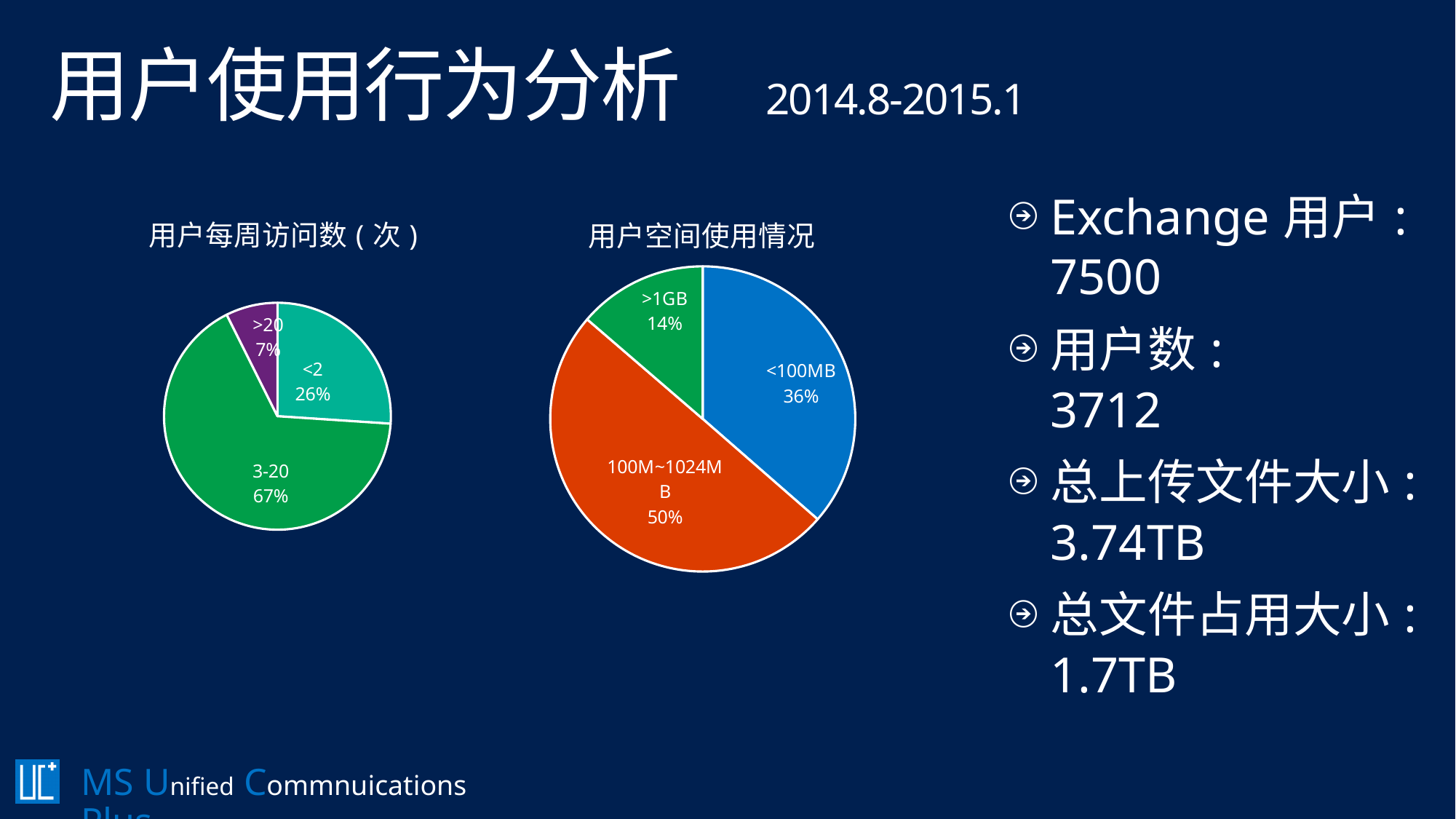
In the right pie chart titled 用户空间使用情况, what share does the <100MB slice have? 36% In the right pie chart titled 用户空间使用情况, which is larger, the <100MB slice or the >1GB slice? <100MB In the right pie chart titled 用户空间使用情况, what share does the >1GB slice have? 14% What kind of chart is the chart titled 用户空间使用情况? Pie chart In the right pie chart titled 用户空间使用情况, what is the difference in percentage points between the <100MB slice and the >1GB slice? 22 In the left pie chart titled 用户每周访问数（次）, which category has the smallest share? >20 In the left pie chart titled 用户每周访问数（次）, what share does the <2 slice have? 26% In the left pie chart titled 用户每周访问数（次）, which category has the largest share? 3-20 In the left pie chart titled 用户每周访问数（次）, how many slices are there? 3 In the left pie chart titled 用户每周访问数（次）, what share does the 3-20 slice have? 67% In the right pie chart titled 用户空间使用情况, which category has the largest share? 100M~1024MB In the left pie chart titled 用户每周访问数（次）, what colour is the 3-20 slice? Green